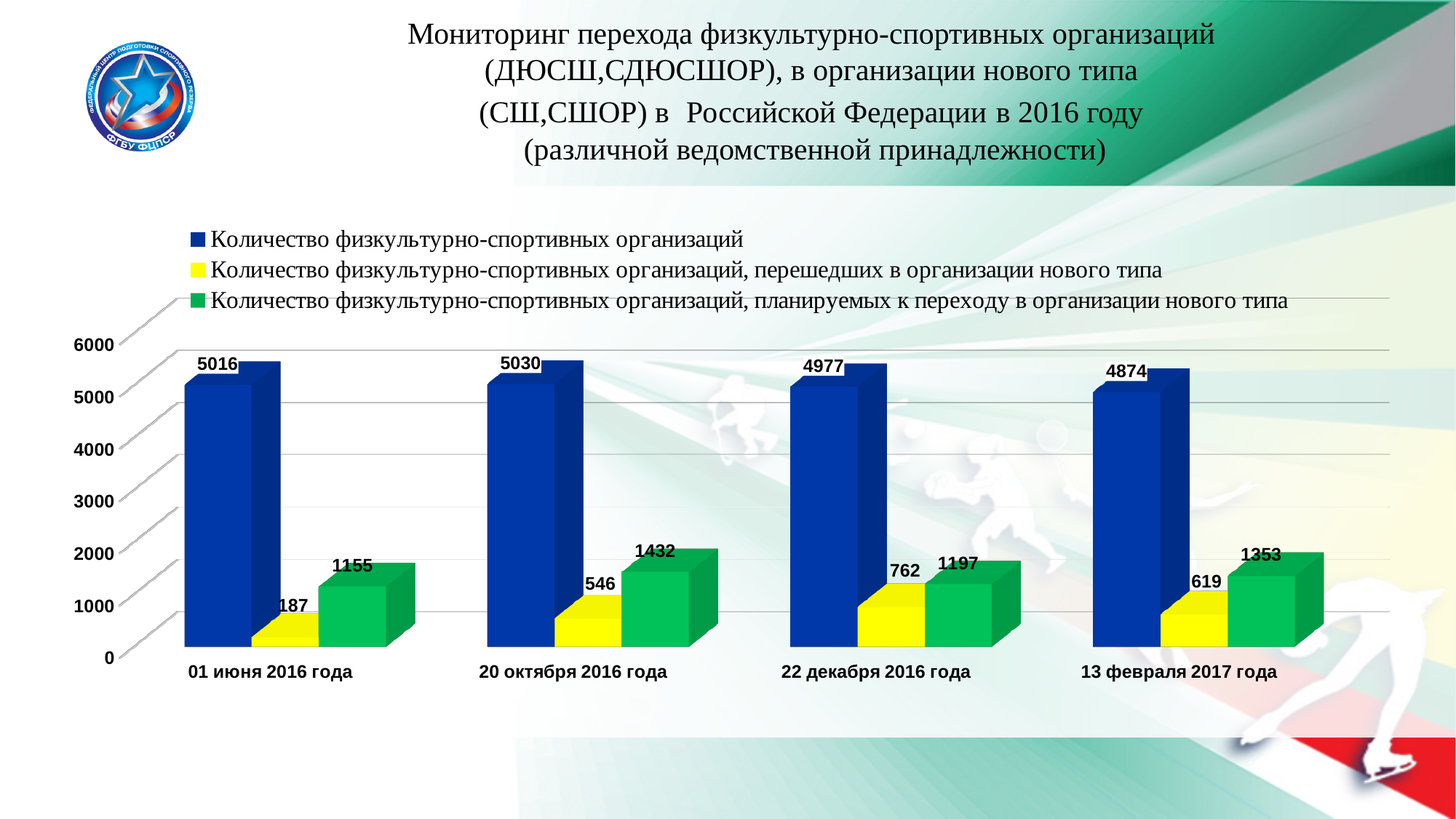
How many series does the legend list? 3 What is the value of 'Количество физкультурно-спортивных организаций' for 20 октября 2016 года? 5030 What is the value of 'Количество физкультурно-спортивных организаций, планируемых к переходу в организации нового типа' for 13 февраля 2017 года? 1353 On which date is the value of 'Количество физкультурно-спортивных организаций, перешедших в организации нового типа' highest? 22 декабря 2016 года On which date is the value of 'Количество физкультурно-спортивных организаций' lowest? 13 февраля 2017 года Which colour represents 'Количество физкультурно-спортивных организаций, перешедших в организации нового типа' in the legend? yellow Which is larger: the 'планируемых к переходу' value for 20 октября 2016 года or for 22 декабря 2016 года? 20 октября 2016 года What is the difference between the 'перешедших' values for 22 декабря 2016 года and 01 июня 2016 года? 575 Is the value of 'Количество физкультурно-спортивных организаций' for 22 декабря 2016 года greater or less than 4000? greater What type of chart is shown on the slide? bar chart What is the value of 'Количество физкультурно-спортивных организаций, перешедших в организации нового типа' for 01 июня 2016 года? 187 How many date categories are shown on the x axis? 4